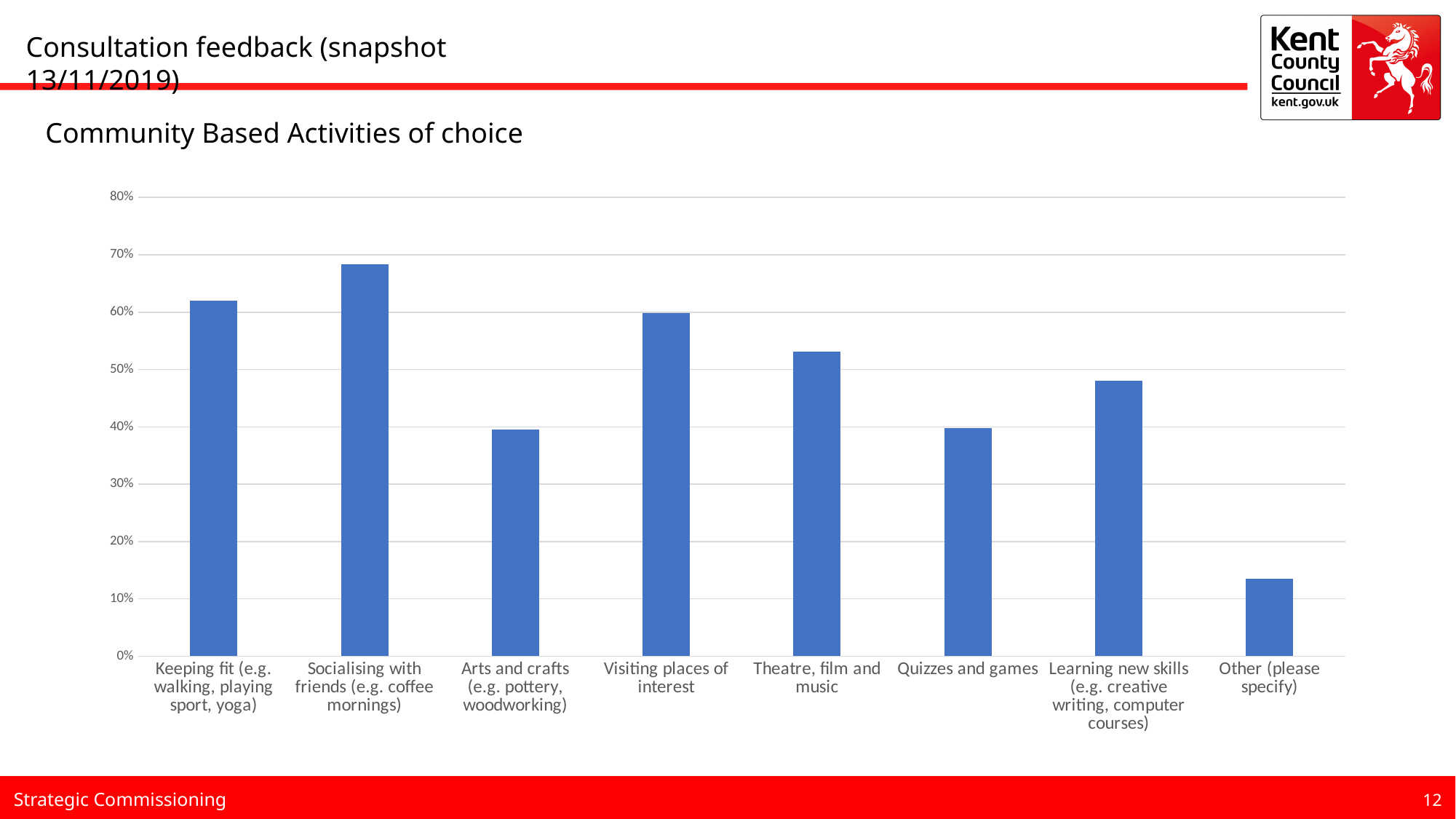
Is the value for Learning new skills greater or less than 40%? greater What kind of chart is shown on the slide? bar chart Which activity has the lowest percentage? Other (please specify) Is the value for Theatre, film and music greater or less than 50%? greater Is the value for Arts and crafts greater or less than 50%? less Which is larger: the value for Keeping fit or the value for Arts and crafts? Keeping fit What is the title of the chart? Community Based Activities of choice How many activity categories are shown on the chart? 8 Which is larger: the value for Theatre, film and music or the value for Quizzes and games? Theatre, film and music Which activity has the highest percentage? Socialising with friends (e.g. coffee mornings)